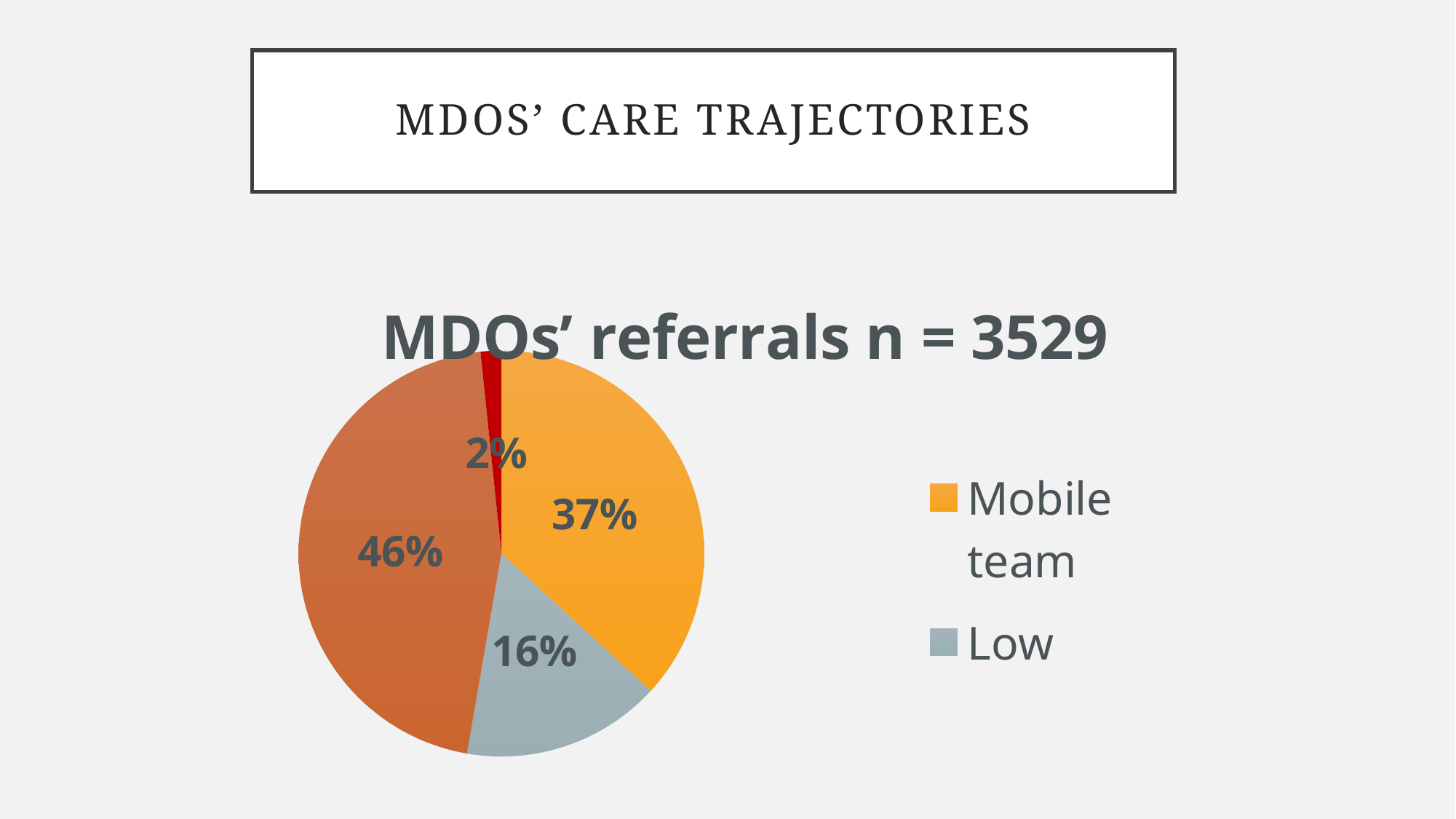
Which slice is larger, Mobile team or Low? Mobile team What is the smallest percentage shown on the pie chart? 2% What is the largest percentage shown on the pie chart? 46% How many entries are listed in the chart's legend? 2 What percentage of MDOs' referrals is labelled Low? 16% What is the title of the chart? MDOs' referrals n = 3529 What kind of chart is shown on the slide? Pie chart What is the total number of MDOs' referrals (n) given in the chart title? 3529 What colour represents the Mobile team in the pie chart? Orange How many slices does the pie chart have? 4 By how many percentage points does the Mobile team slice exceed the Low slice? 21% What percentage of MDOs' referrals went to the Mobile team? 37%